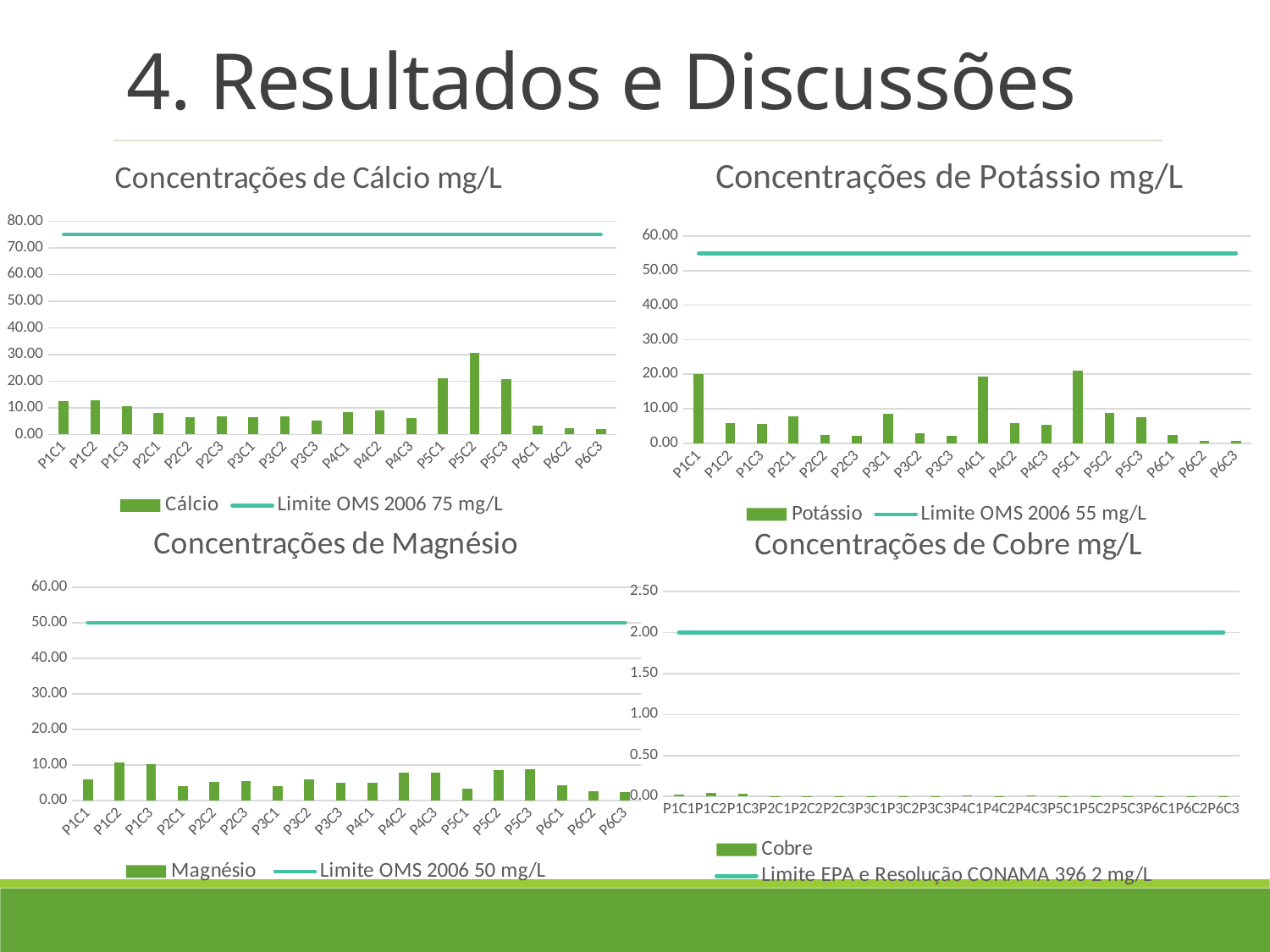
How many categories are shown on the x axis of the chart titled "Concentrações de Magnésio"? 18 In the chart titled "Concentrações de Cálcio mg/L", which category has the highest bar? P5C2 In the chart titled "Concentrações de Cálcio mg/L", is the value for P5C2 greater or less than 20? greater In the chart titled "Concentrações de Cálcio mg/L", which is larger, the value for P5C2 or the value for P1C1? P5C2 How many series does the legend of the chart titled "Concentrações de Cobre mg/L" list? 2 What is the name of the line series in the legend of the chart titled "Concentrações de Cobre mg/L"? Limite EPA e Resolução CONAMA 396 2 mg/L What kind of chart is the chart titled "Concentrações de Potássio mg/L"? Bar chart with a line In the chart titled "Concentrações de Potássio mg/L", is the value for P4C1 greater or less than 10? greater According to the legend of the chart titled "Concentrações de Cálcio mg/L", what limit value does the horizontal line represent? 75 mg/L In the chart titled "Concentrações de Cálcio mg/L", is the value for P1C1 greater or less than 20? less In the chart titled "Concentrações de Potássio mg/L", which is larger, the value for P1C1 or the value for P1C2? P1C1